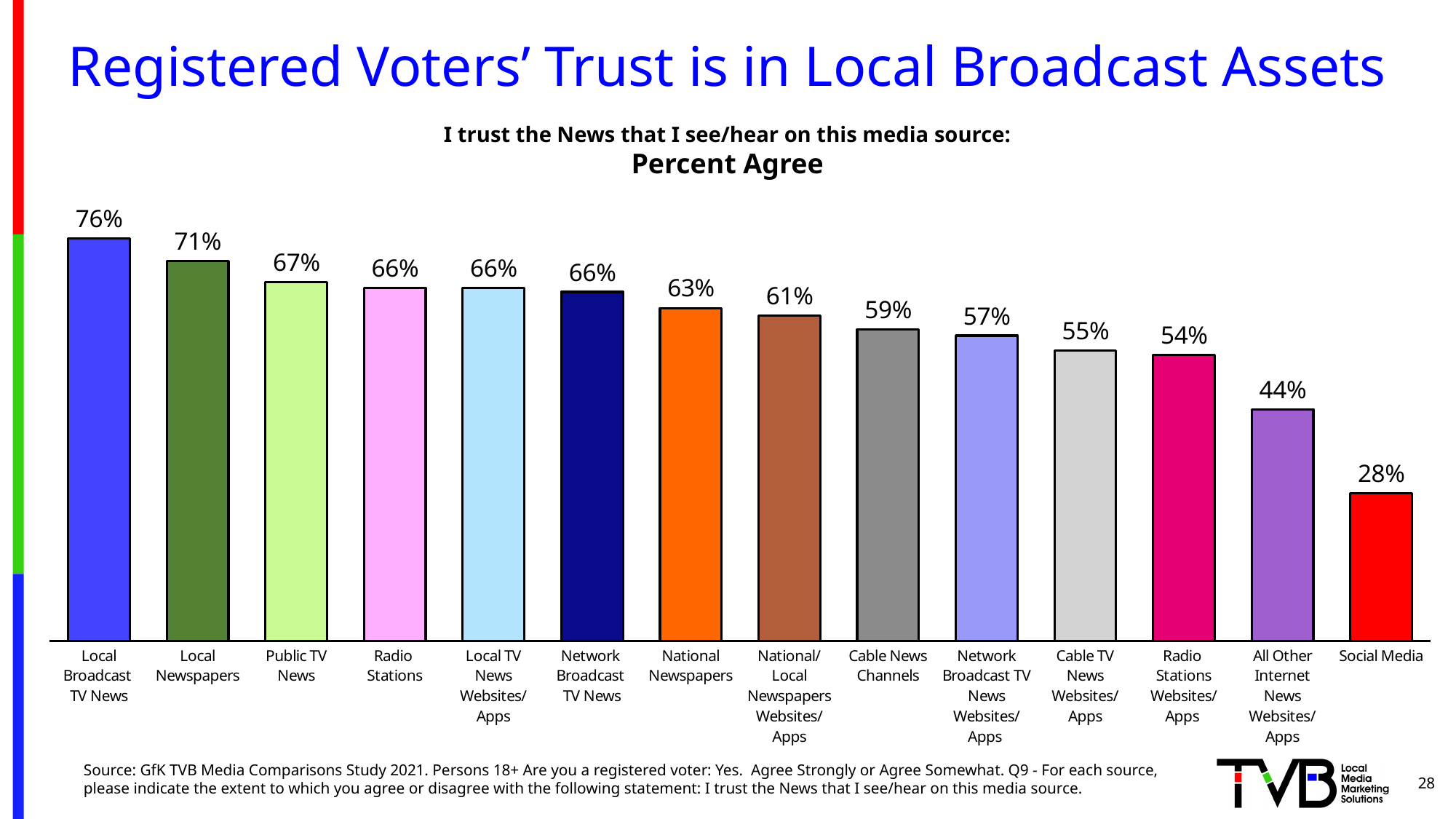
What percent of registered voters agree they trust the news on Local Broadcast TV News? 76% What is the percent agree value for Social Media? 28% What is the percent agree value for All Other Internet News Websites/Apps? 44% How many media sources are shown in the chart? 14 Do the values rise or fall moving from left to right across the chart? Fall What is the difference in percent agree between Local Newspapers and National Newspapers? 8 percentage points Which media source has the lowest percent agree? Social Media Which has a higher percent agree, Radio Stations or Radio Stations Websites/Apps? Radio Stations What is the percent agree value for Cable News Channels? 59% Which media source has the highest percent agree? Local Broadcast TV News What type of chart is shown on the slide? Bar chart What is the difference in percent agree between Local Broadcast TV News and Social Media? 48 percentage points